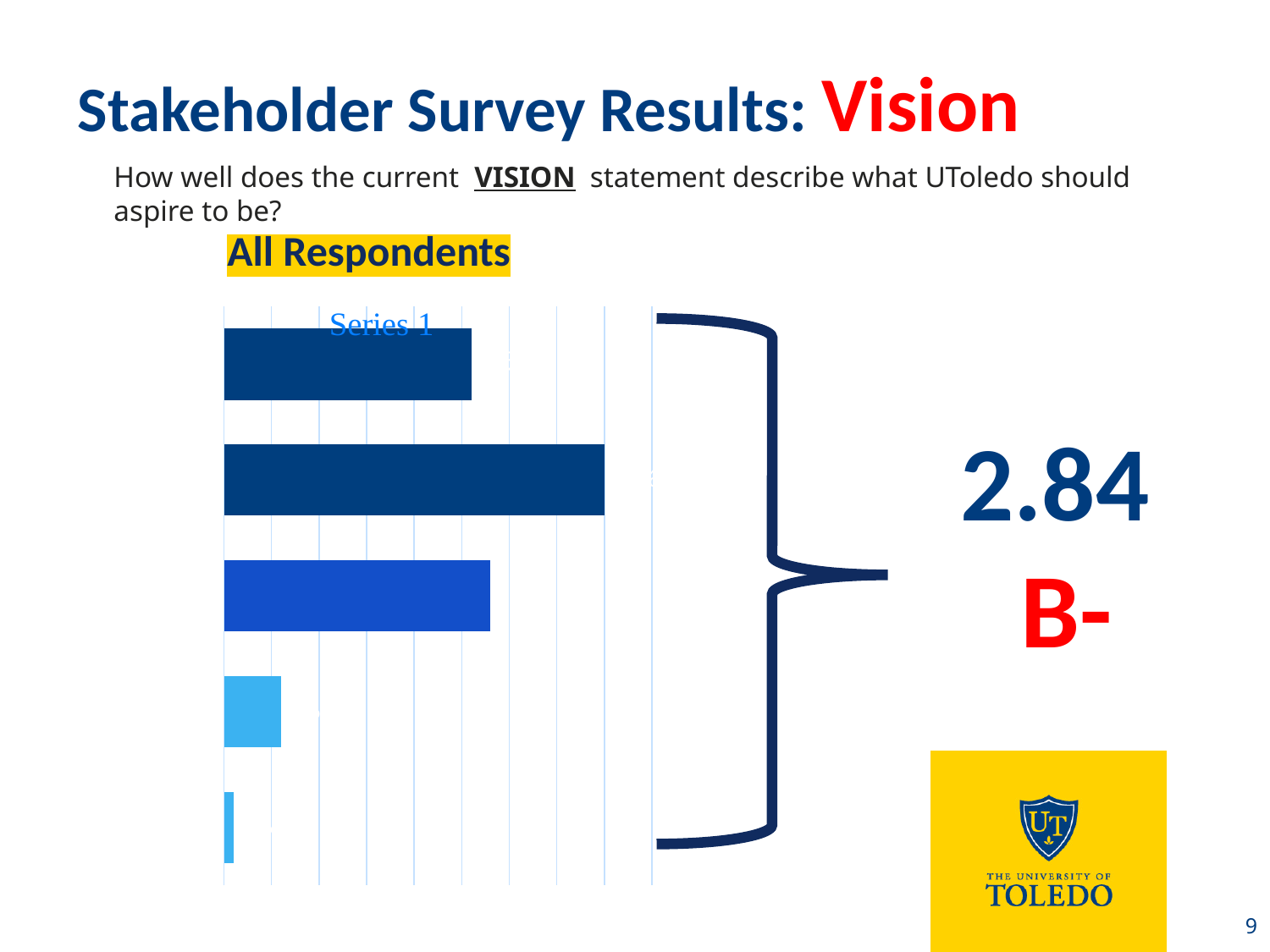
What heading is highlighted in yellow above the chart? All Respondents What kind of chart is shown on the slide? bar chart Do the bar lengths consistently decrease from the top bar to the bottom bar? No What title is printed at the top of the chart? Series 1 Which bar in the chart is the shortest, counting from the top? the bottom (fifth) bar How many bars are plotted in the chart? 5 Is the second bar from the top longer or shorter than the top bar? longer Is the top bar longer or shorter than the bottom bar? longer Which bar in the chart is the longest, counting from the top? the second bar Is the fourth bar from the top longer or shorter than the third bar from the top? shorter